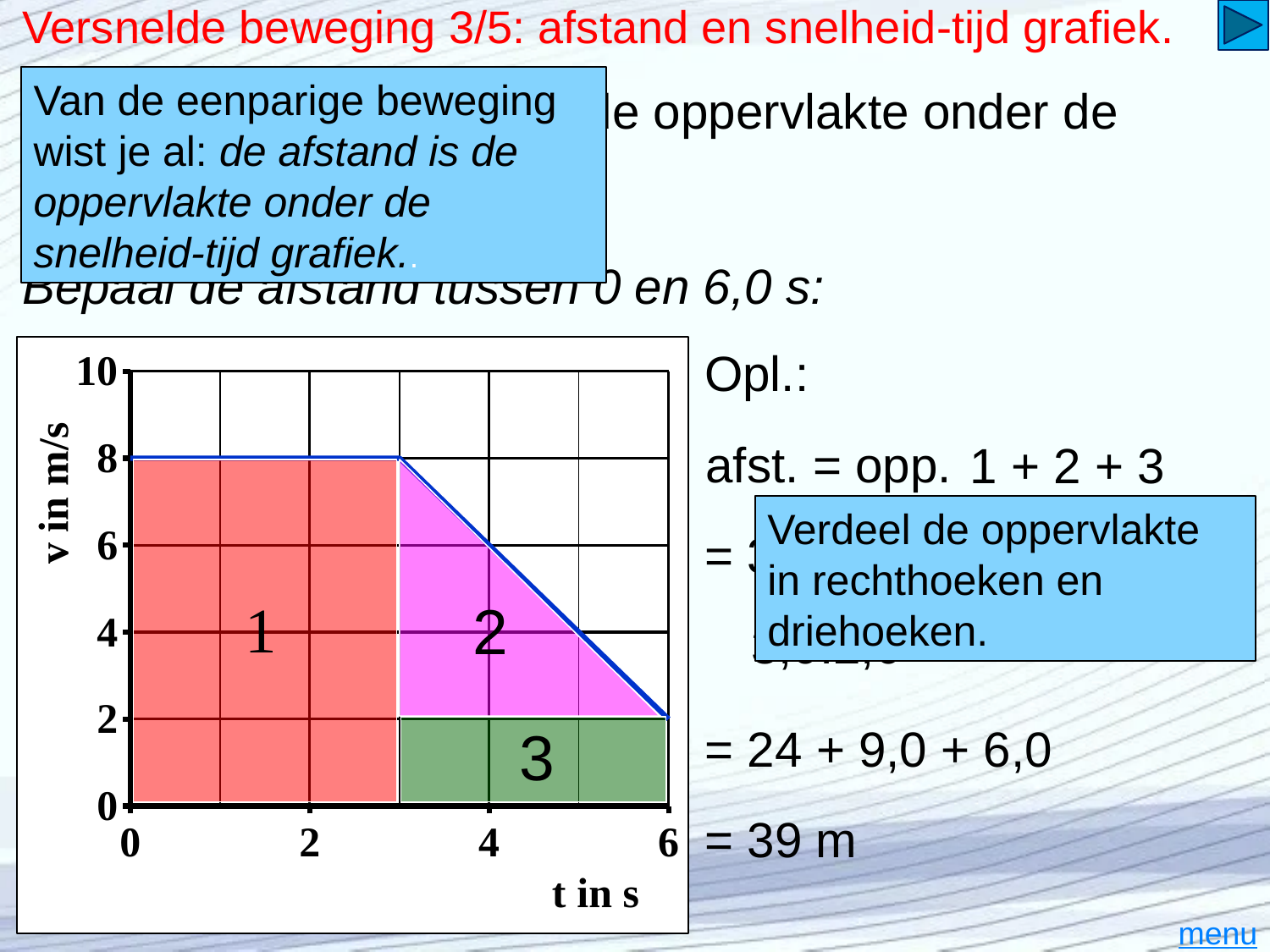
What is the velocity v at t = 0 s? 8 m/s What kind of chart is shown on the slide? line chart What is the label on the vertical axis of the graph? v in m/s Is the velocity at t = 5 s greater or less than 6 m/s? less What is the highest velocity value reached on the graph? 8 m/s Does the velocity rise, fall or stay constant between t = 3 s and t = 6 s? fall What is the lowest velocity value on the graph between t = 0 s and t = 6 s? 2 m/s What is the velocity v at t = 6 s? 2 m/s How many numbered shaded regions are marked under the graph? 3 What is the difference between the velocity at t = 0 s and the velocity at t = 6 s? 6 m/s Which is larger: the velocity at t = 2 s or the velocity at t = 6 s? t = 2 s What is the velocity v at t = 4 s? 6 m/s